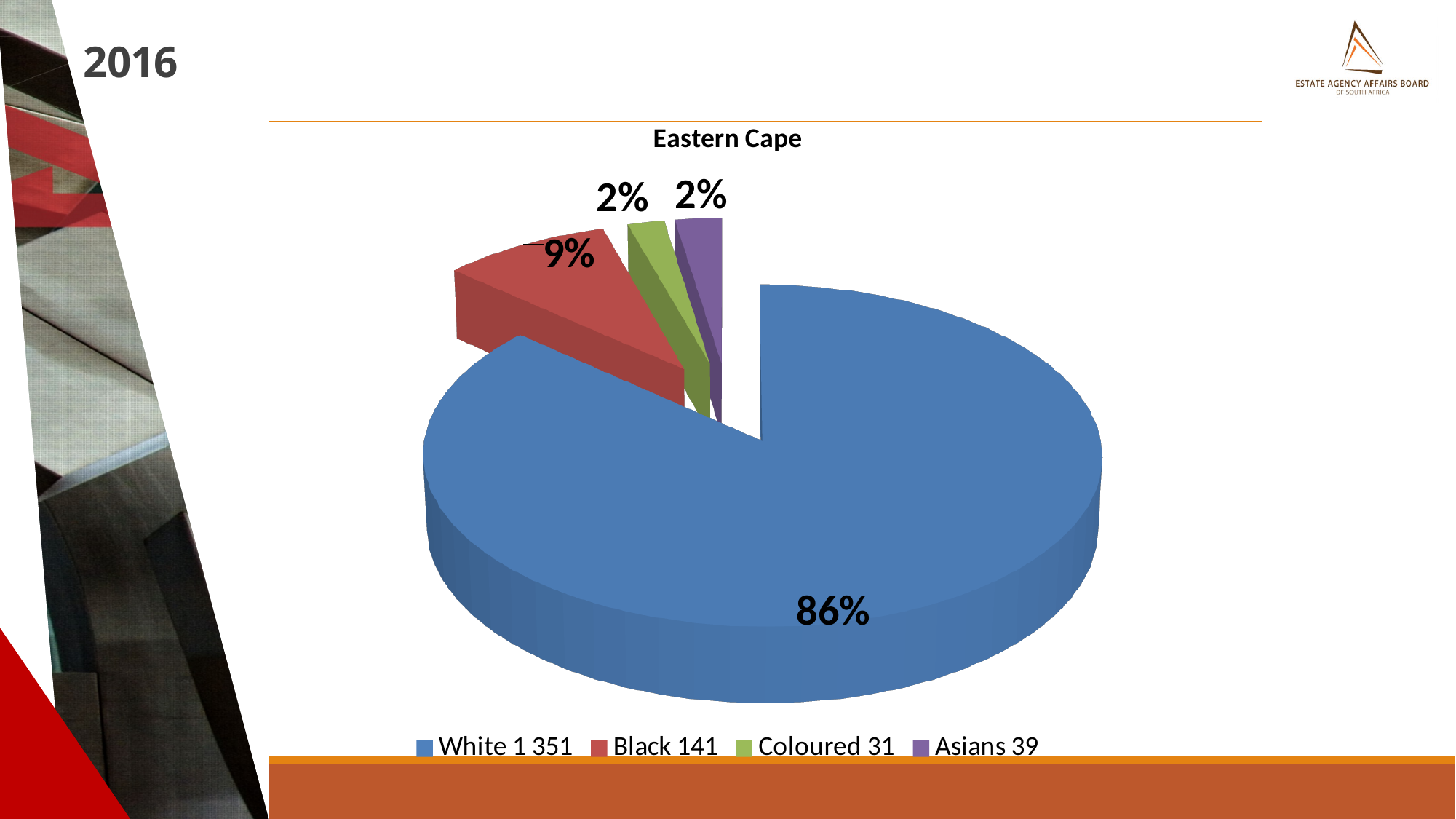
What is the difference between the counts for Asians and Coloured shown in the legend? 8 What percentage of the pie does the White slice represent? 86% Which slice is larger, Black or Asians? Black What is the difference in percentage points between the White slice and the Black slice? 77% What kind of chart is shown on the slide? pie chart Which category has the largest slice of the pie? White How many categories does the pie chart have? 4 What is the title of the chart? Eastern Cape What percentage of the pie does the Black slice represent? 9% According to the legend, which category has the smallest count? Coloured What percentage of the pie does the Coloured slice represent? 2% What count is shown for White in the legend? 1 351